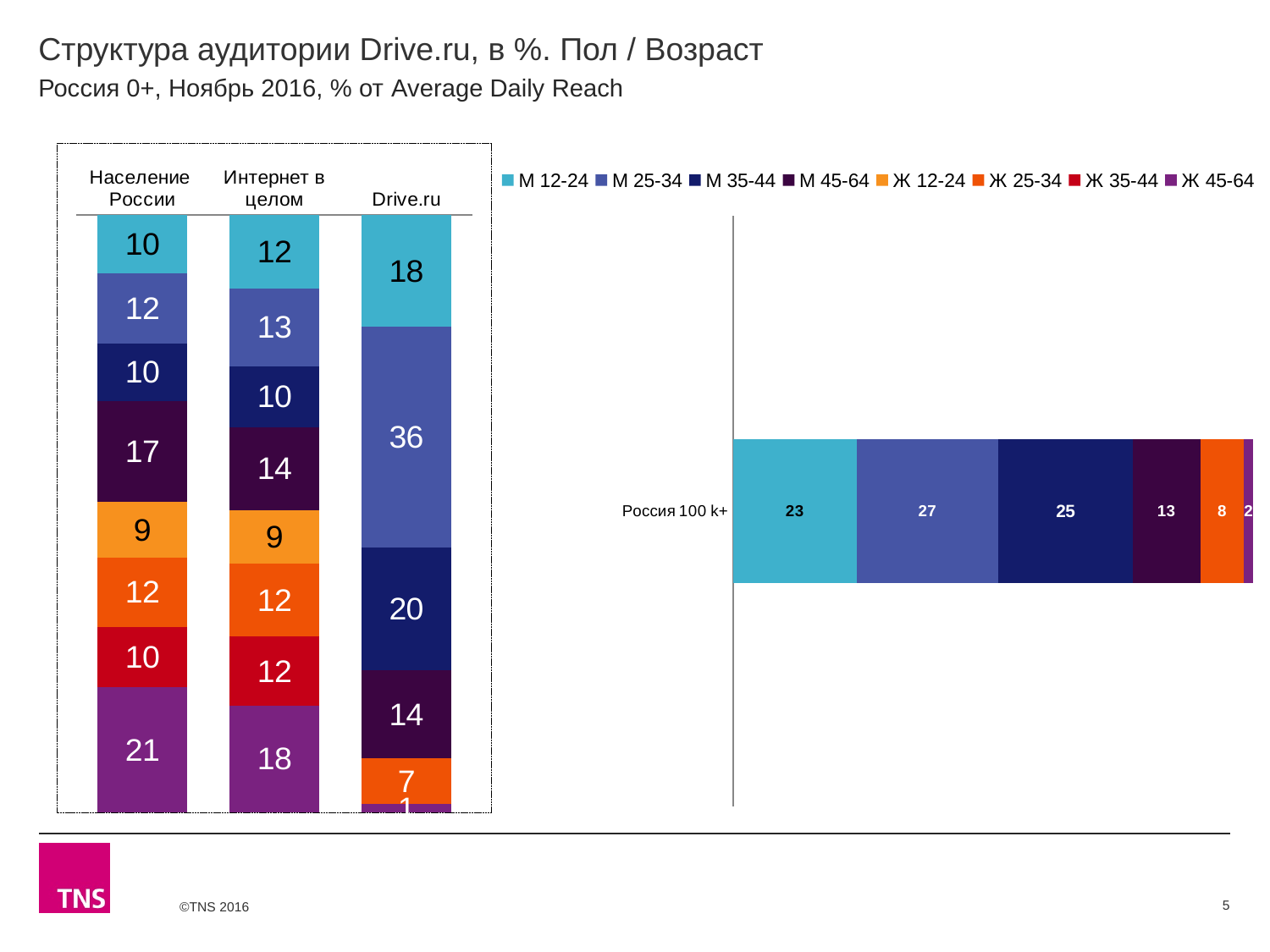
In the right chart (Россия 100 k+), which segment has the highest value? М 25-34 In the left chart, what is the difference between the М 25-34 value for Drive.ru and the М 25-34 value for Население России? 24 In the left chart, what is the value of the Ж 45-64 segment for Население России? 21 In the left chart, which of the three bars has the largest М 25-34 segment? Drive.ru In the left chart, how many bars (categories) are shown? 3 In the left chart, what is the value of the М 45-64 segment for Интернет в целом? 14 What kind of chart is the right chart (Россия 100 k+)? Stacked bar chart In the left chart, which is larger: the М 45-64 value for Население России or for Интернет в целом? Население России In the right chart (Россия 100 k+), what is the value of the М 12-24 segment? 23 In the right chart (Россия 100 k+), what is the difference between the М 25-34 and М 35-44 values? 2 In the left chart, what is the value of the М 25-34 segment for Drive.ru? 36 How many series does the legend list? 8